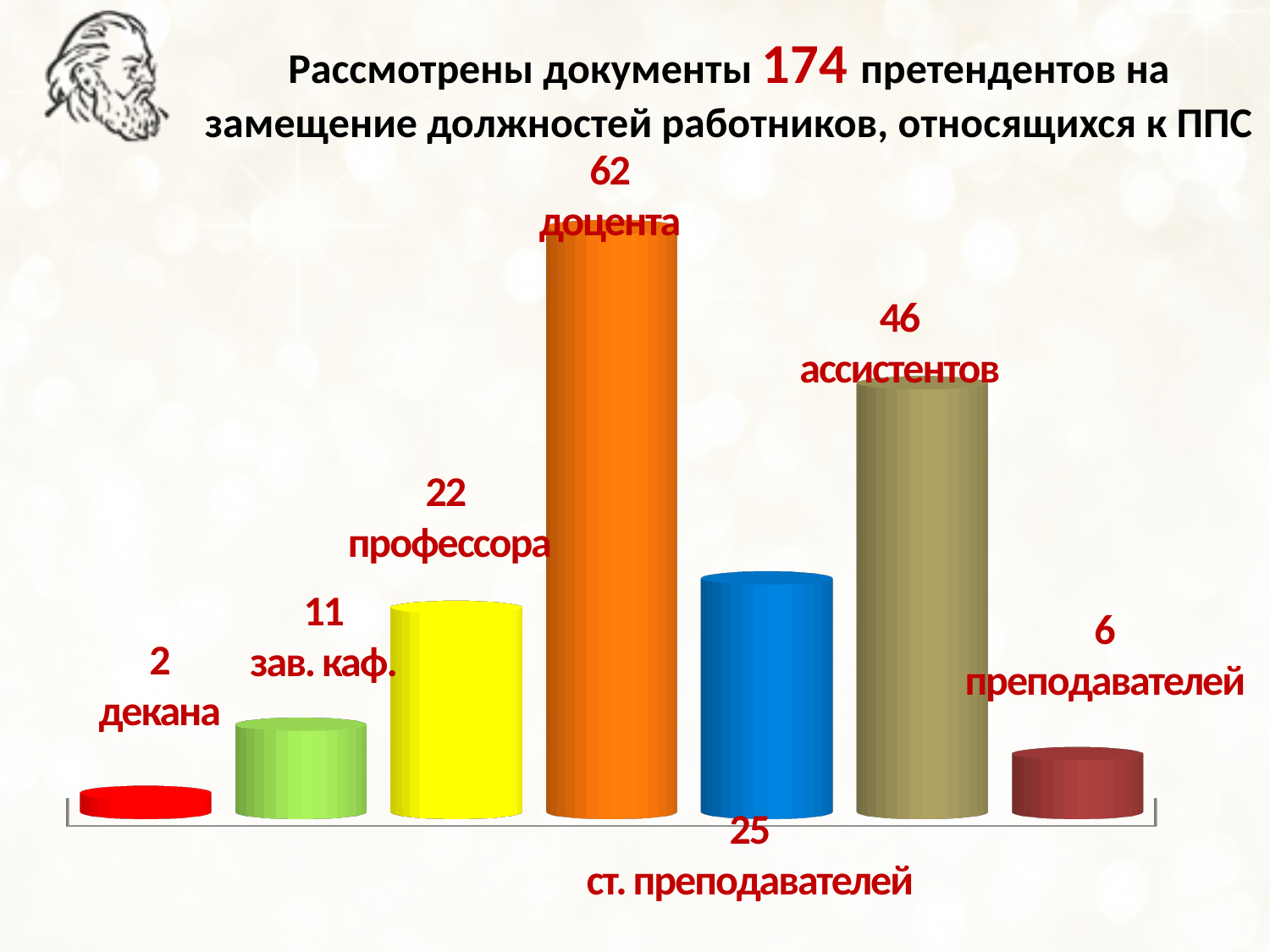
Which category has the lowest value on the chart? декана What value is shown for ст. преподавателей? 25 Which category has the highest value on the chart? доцента What value is shown for зав. каф.? 11 What kind of chart is shown on the slide? bar chart What is the difference between the values for профессора and зав. каф.? 11 What is the difference between the values for доцента and ассистентов? 16 How many categories are shown on the chart? 7 Which is larger, the value for ст. преподавателей or the value for профессора? ст. преподавателей What value is shown for ассистентов? 46 What total number of applicants is stated in the slide title? 174 How many applicants for the position of доцента are shown on the chart? 62